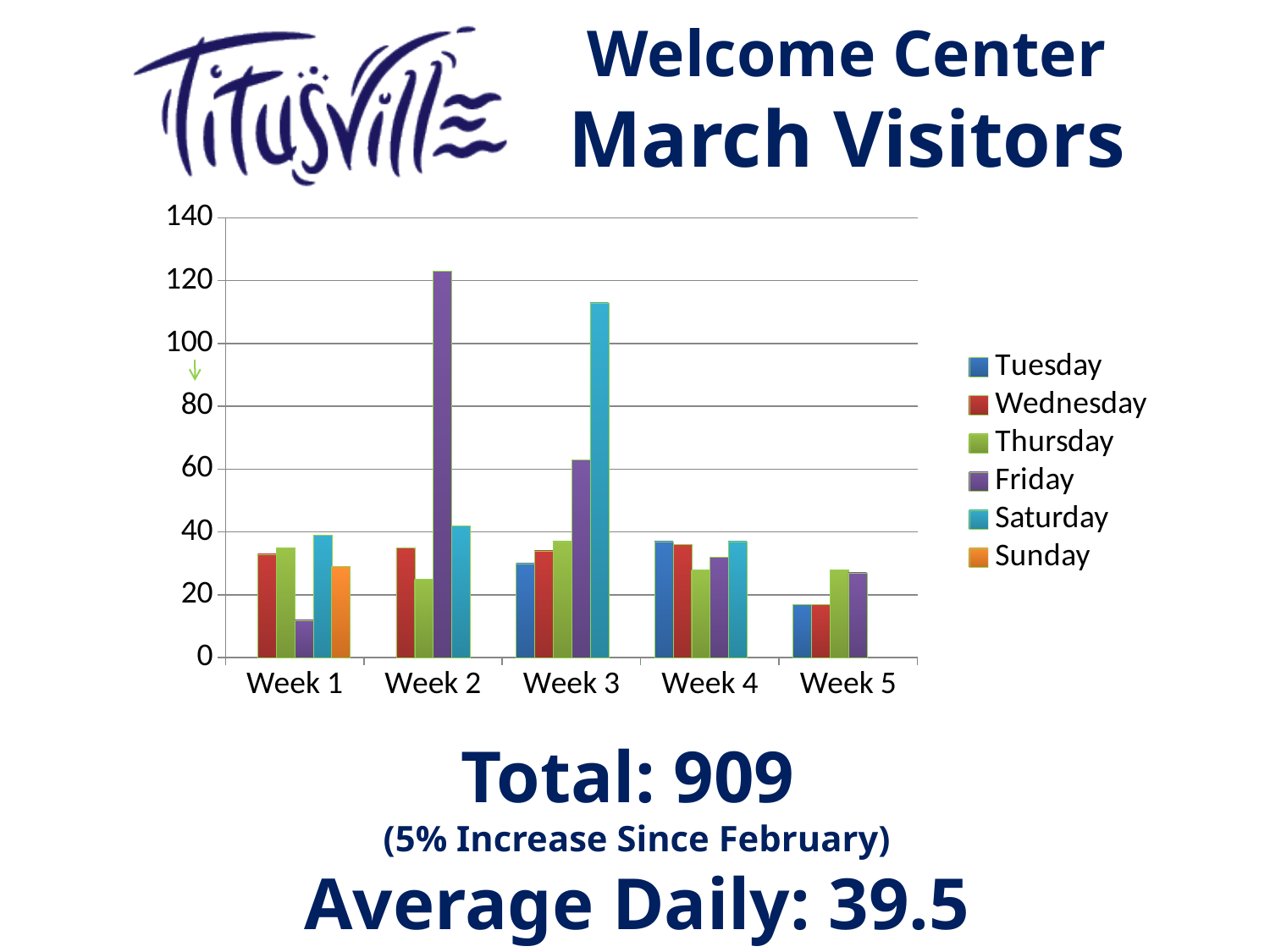
How many weeks are shown on the x axis of the chart? 5 How many series does the chart's legend list? 6 What total number of March visitors is stated on the slide? 909 In Week 3, which is larger, the Friday bar or the Saturday bar? Saturday Is the value for Saturday in Week 3 greater or less than 100? greater Which series is listed last in the chart's legend? Sunday Is the value for Thursday in Week 5 greater or less than 20? greater Which week contains the tallest bar in the chart? Week 2 Is the value for Friday in Week 2 greater or less than 100? greater What kind of chart is shown on the slide? bar chart Which week has the lowest Friday bar? Week 1